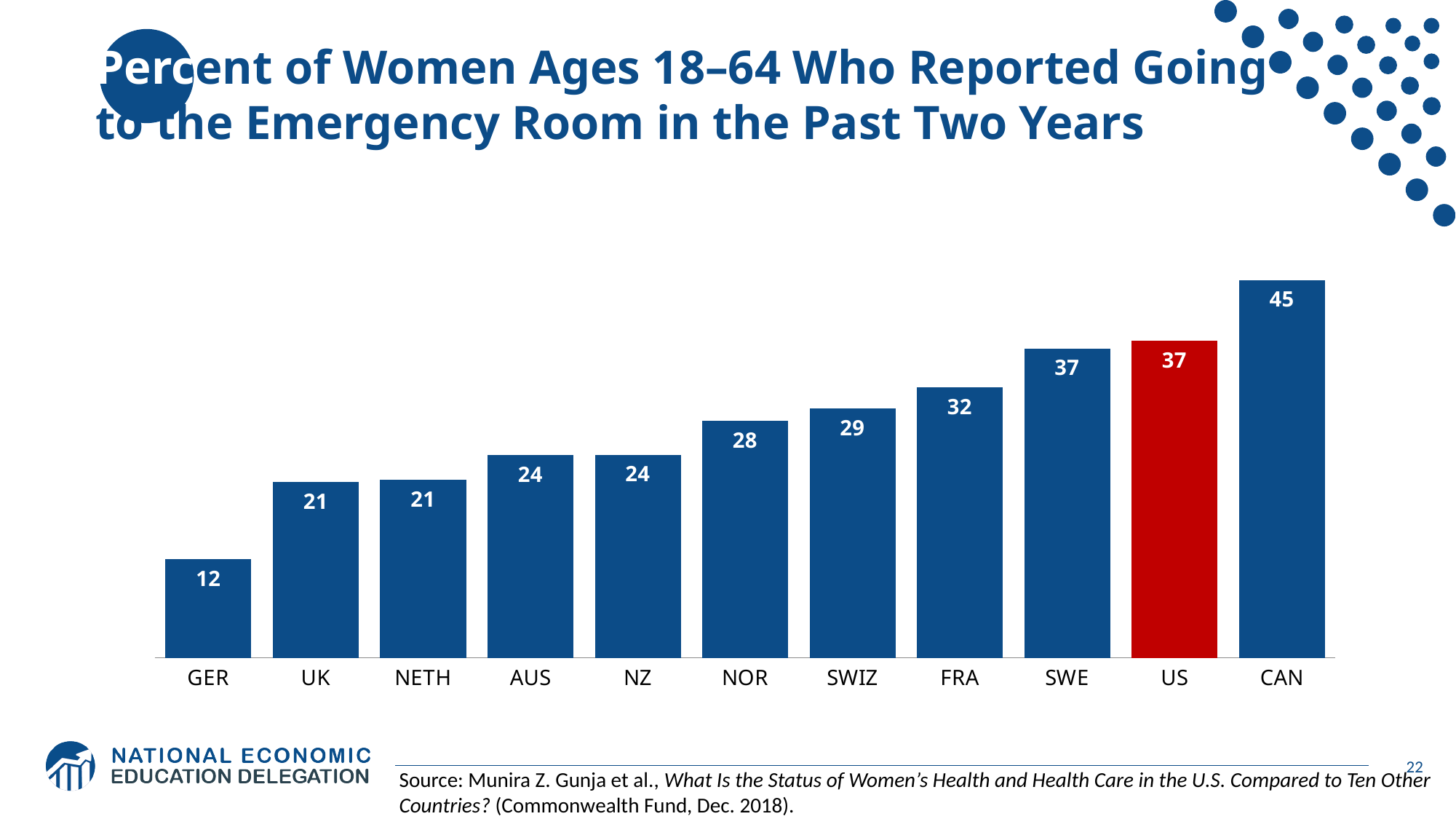
What is the value for NOR? 28 What is the difference between the values for FRA and UK? 11 Which country's bar is coloured red? US What is the difference between the values for CAN and the US? 8 Do the values rise or fall from left to right along the x axis? Rise Which country has the highest value? CAN Which is larger, the value for SWIZ or the value for AUS? SWIZ How many countries are shown on the chart? 11 What is the value for GER? 12 Which country has the lowest value? GER What is the value for the US? 37 What kind of chart is shown on the slide? Bar chart